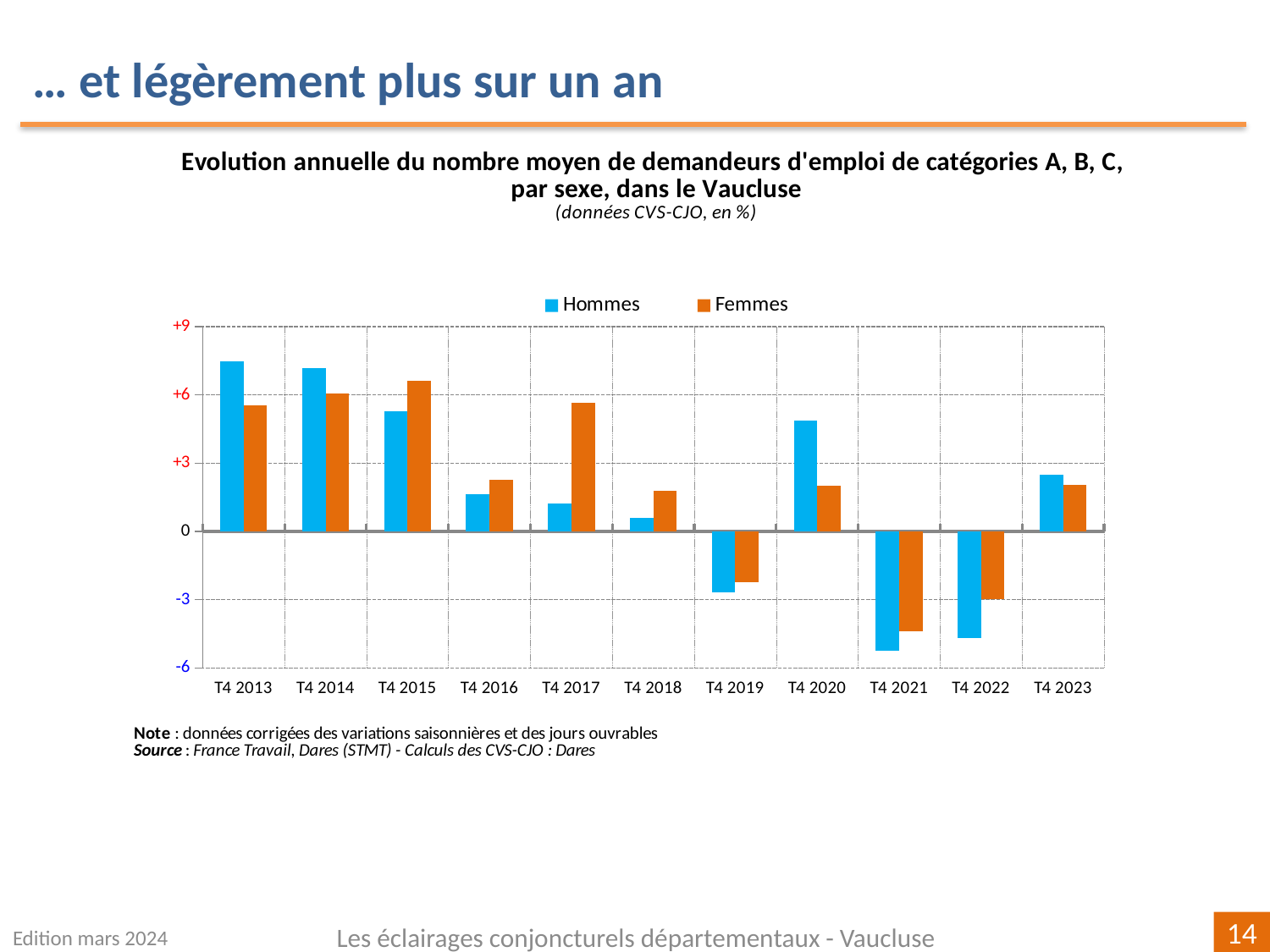
Is the Hommes value for T4 2021 greater or less than -3? less In T4 2020, which series has the larger value, Hommes or Femmes? Hommes In which quarter is the Femmes value the lowest? T4 2021 Which series is shown in orange? Femmes How many quarters (categories) are shown on the x axis? 11 In T4 2017, which series has the larger value, Hommes or Femmes? Femmes Is the Femmes value for T4 2017 greater or less than +3? greater What kind of chart is shown on the slide? bar chart In which quarter is the Hommes value the lowest? T4 2021 How many series does the legend list? 2 In which quarter is the Femmes value the highest? T4 2015 Is the Hommes value for T4 2013 greater or less than +6? greater